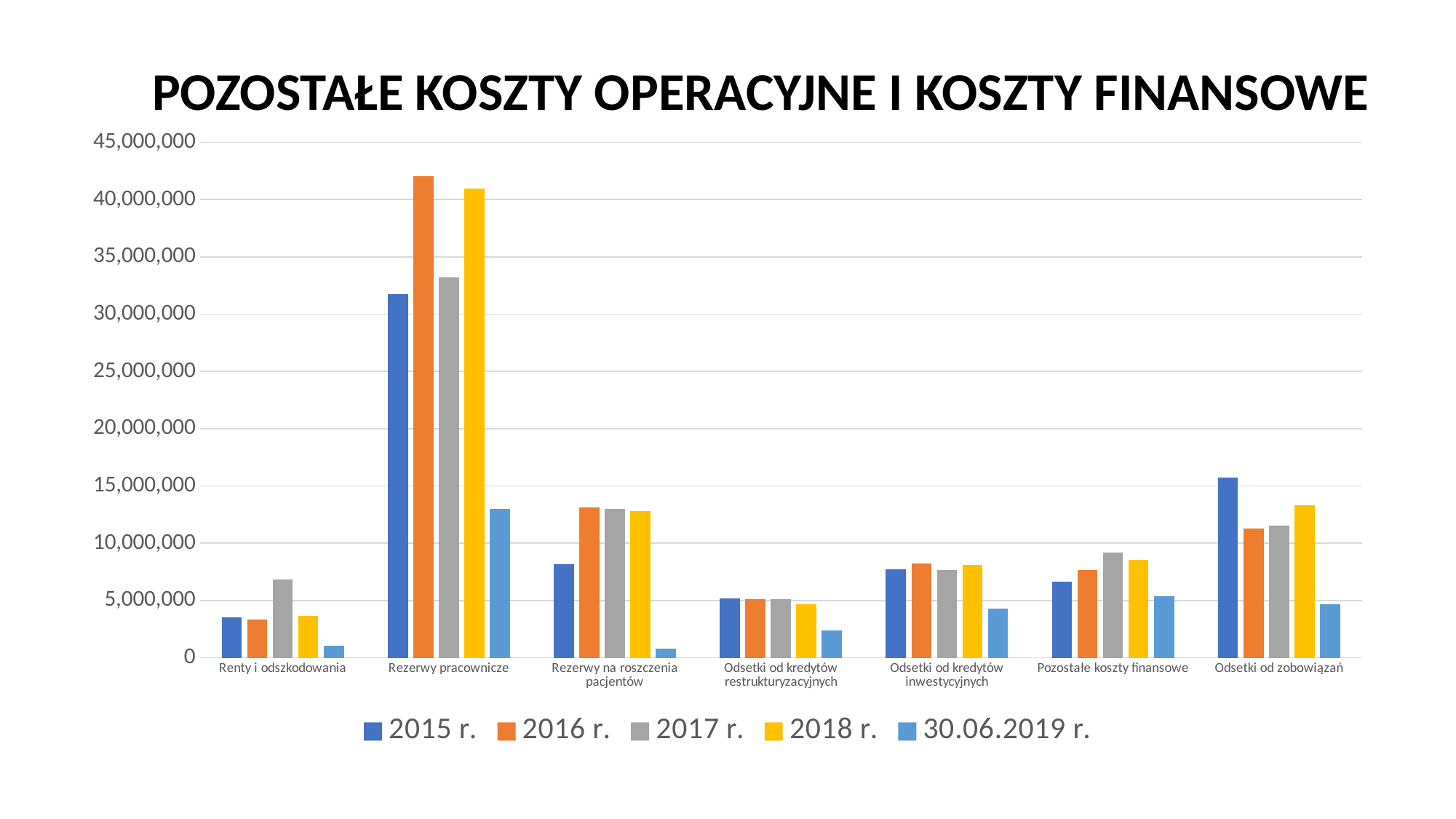
Within the Rezerwy pracownicze category, which series has the lowest value? 30.06.2019 r. What kind of chart is shown on the slide? bar chart Which category has the highest value for the 2015 r. series? Rezerwy pracownicze For Pozostałe koszty finansowe, which is larger: the value for 2017 r. or the value for 2015 r.? 2017 r. Is the value for Rezerwy na roszczenia pacjentów at 30.06.2019 r. greater or less than 5,000,000? less Is the value for Rezerwy pracownicze in 2016 r. greater or less than 40,000,000? greater Is the value for Rezerwy pracownicze in 2015 r. greater or less than 30,000,000? greater How many series does the legend list? 5 What is the title of the chart? POZOSTAŁE KOSZTY OPERACYJNE I KOSZTY FINANSOWE How many categories are shown on the x axis of the chart? 7 For Odsetki od zobowiązań, which is larger: the value for 2015 r. or the value for 2018 r.? 2015 r.